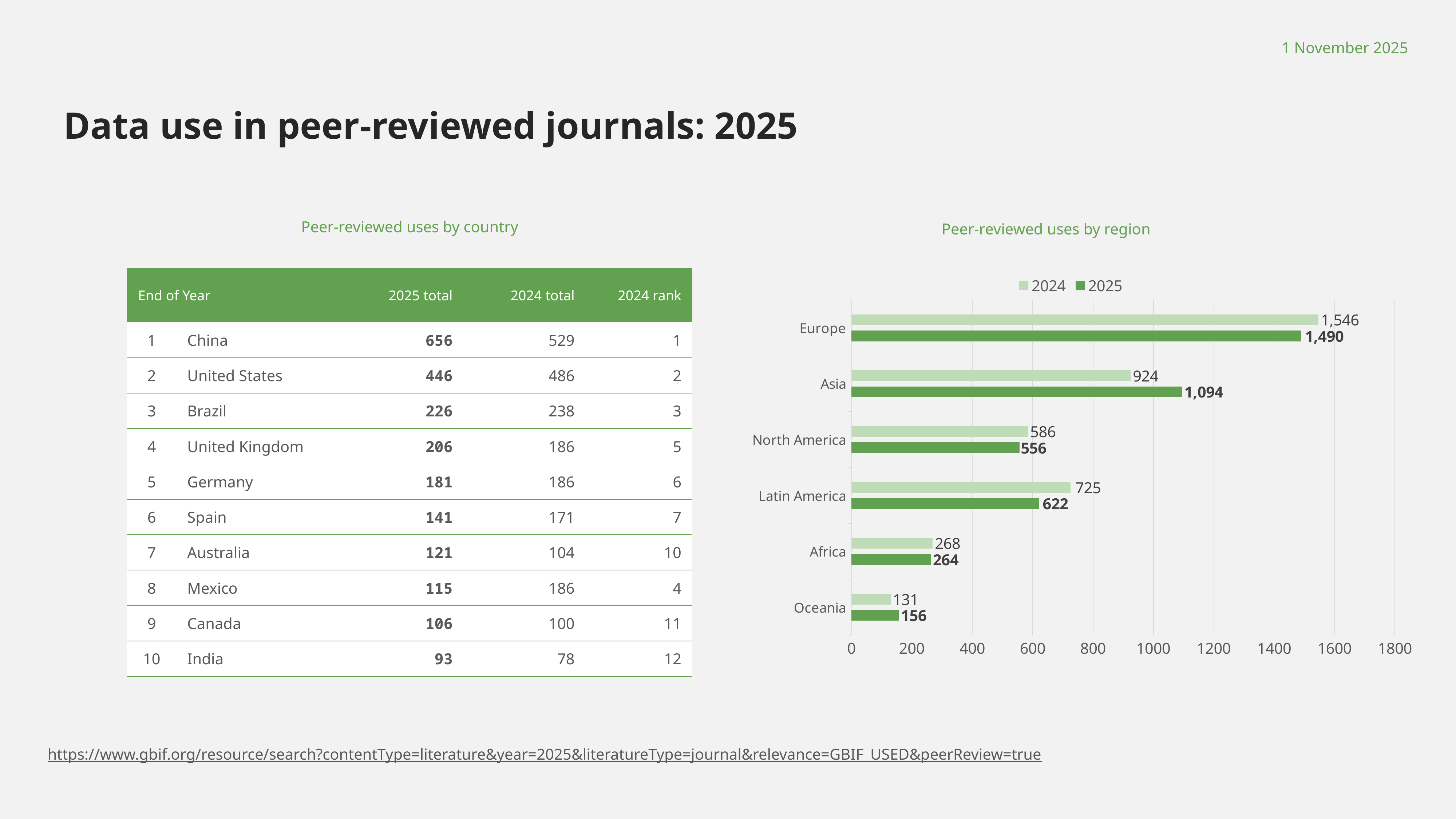
What are the two series named in the legend of the 'Peer-reviewed uses by region' chart? 2024 and 2025 In the 'Peer-reviewed uses by region' chart, which region has the lowest 2024 value? Oceania How many series does the legend of the 'Peer-reviewed uses by region' chart list? 2 In the 'Peer-reviewed uses by region' chart, what is the difference between the 2024 and 2025 values for Europe? 56 In the 'Peer-reviewed uses by region' chart, what is the 2024 value for Latin America? 725 What type of chart is 'Peer-reviewed uses by region'? bar chart How many regions are shown in the 'Peer-reviewed uses by region' chart? 6 In the 'Peer-reviewed uses by region' chart, which region has the highest 2025 value? Europe In the 'Peer-reviewed uses by region' chart, is the 2025 value for Asia larger or smaller than its 2024 value? larger In the 'Peer-reviewed uses by region' chart, what is the 2025 value for Asia? 1,094 In the 'Peer-reviewed uses by region' chart, what is the 2025 value for Oceania? 156 In the 'Peer-reviewed uses by region' chart, is the 2025 value for North America greater or less than 600? less